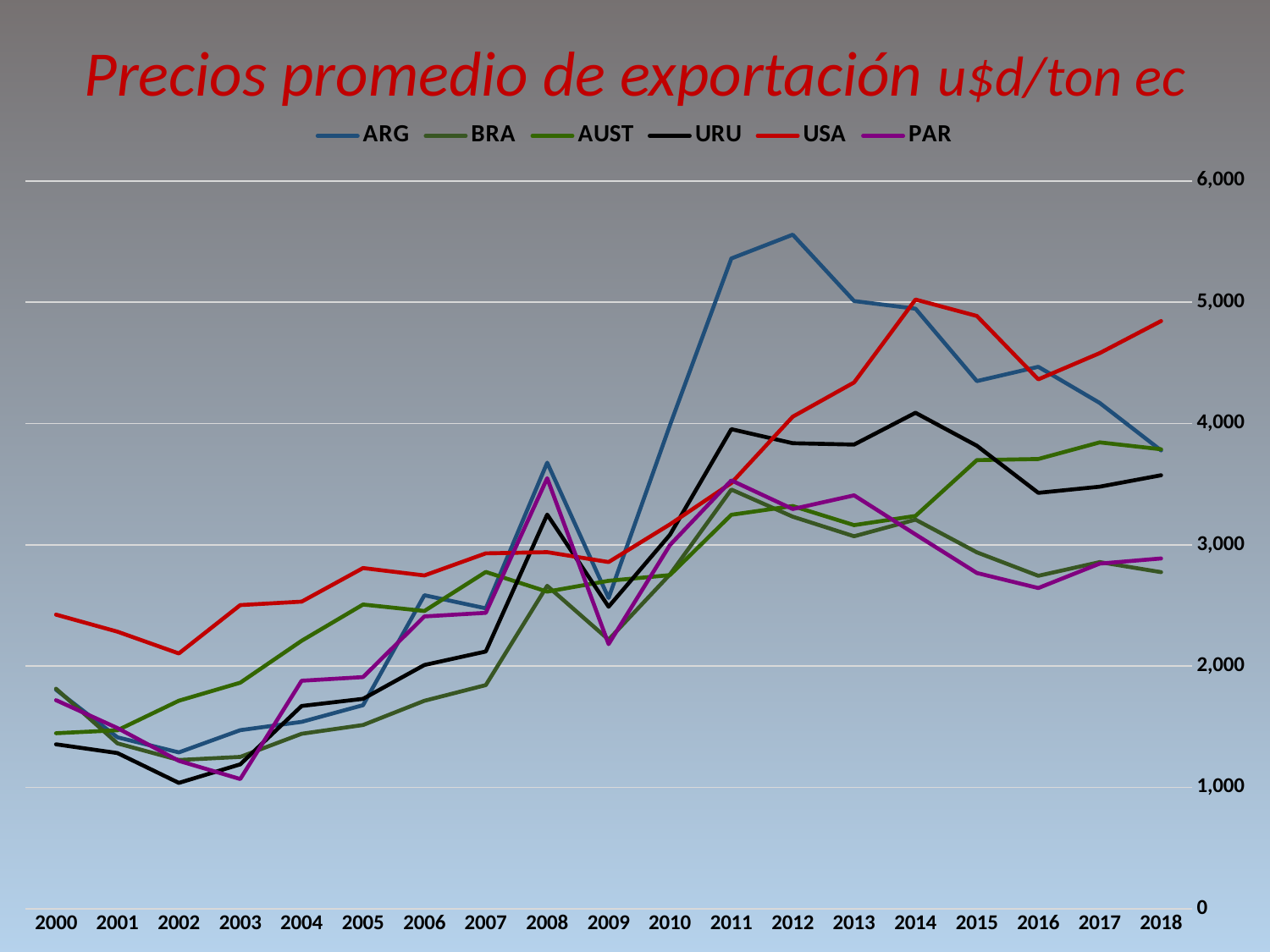
Which series has the highest value in 2000? USA Does the ARG series rise or fall from 2012 to 2018? fall Which series has the highest value in 2012? ARG In which year does the ARG series reach its peak? 2012 What kind of chart is shown on the slide? line chart What is the title of the chart? Precios promedio de exportación u$d/ton ec How many years are shown on the x axis? 19 Is the value for BRA in 2018 greater or less than 3,000? less How many series does the legend list? 6 Which is larger in 2018, the value for USA or the value for URU? USA Is the value for ARG in 2012 greater or less than 5,000? greater